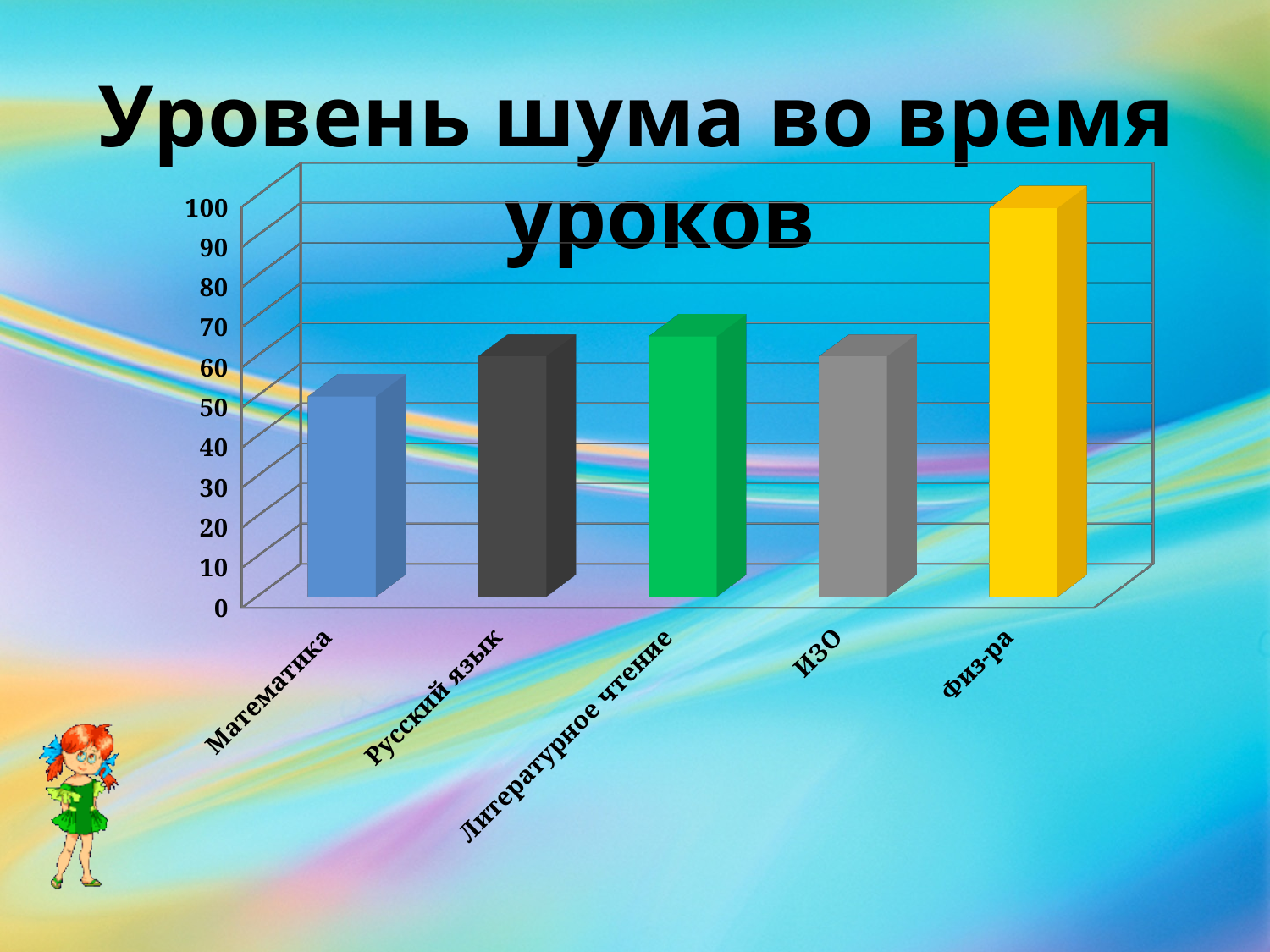
What kind of chart is shown on the slide? bar chart Which has a higher noise level, Физ-ра or Математика? Физ-ра Is the value for Математика greater or less than 70? less How many categories (lessons) are shown on the chart? 5 What is the title of the chart? Уровень шума во время уроков What colour is the bar for Физ-ра? yellow Which lesson has the lowest noise level? Математика Is the value for Литературное чтение greater or less than 40? greater Is the value for ИЗО greater or less than 90? less Which lesson has the highest noise level? Физ-ра Which has a higher noise level, Литературное чтение or Математика? Литературное чтение